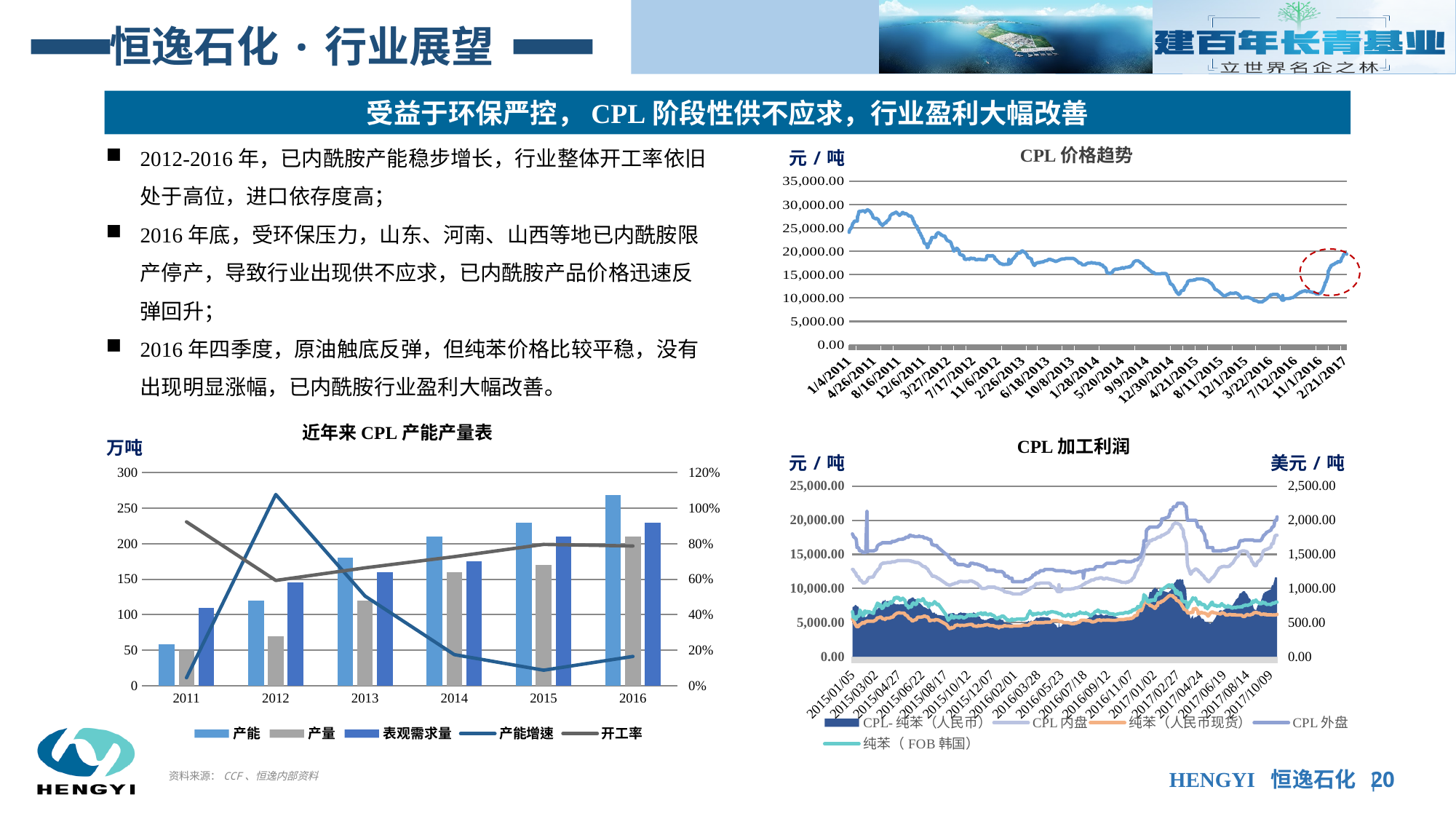
How many series does the legend of the "近年来CPL产能产量表" chart list? 5 In the "CPL 价格趋势" chart, do values overall rise or fall from 1/4/2011 to 2/21/2017? fall In the "近年来CPL产能产量表" chart, is the 产量 value for 2012 greater or less than 100? less In the "近年来CPL产能产量表" chart, which is larger in 2014, the 产能 bar or the 产量 bar? 产能 How many series does the legend of the "CPL 加工利润" chart list? 5 In the "近年来CPL产能产量表" chart, which year has the lowest 产量 bar? 2011 In the "近年来CPL产能产量表" chart, which year has the highest 产能 bar? 2016 In the "近年来CPL产能产量表" chart, is the 产能增速 value for 2015 greater or less than 20%? less What type of chart is the "CPL 价格趋势" chart? line chart In the "近年来CPL产能产量表" chart, how many years are shown on the x axis? 6 In the "近年来CPL产能产量表" chart, is the 产能 value for 2016 greater or less than 250? greater What is the unit label on the right-hand y axis of the "CPL 加工利润" chart? 美元/吨